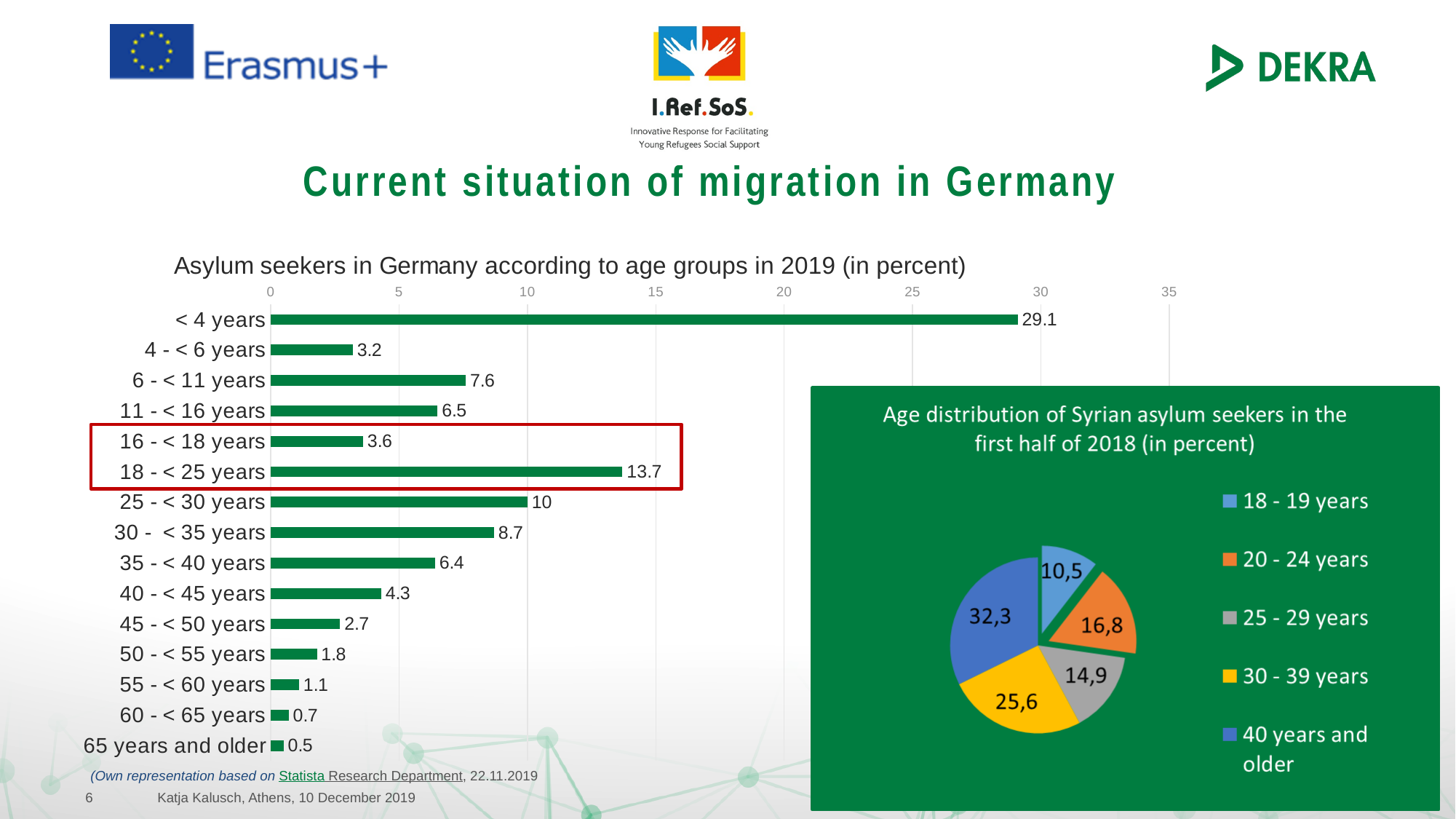
In the pie chart 'Age distribution of Syrian asylum seekers in the first half of 2018 (in percent)', which age group has the smallest slice? 18 - 19 years In the bar chart 'Asylum seekers in Germany according to age groups in 2019 (in percent)', what is the value for '18 - < 25 years'? 13.7 In the pie chart 'Age distribution of Syrian asylum seekers in the first half of 2018 (in percent)', what colour is the slice for '30 - 39 years'? Yellow How many entries does the legend of the pie chart 'Age distribution of Syrian asylum seekers in the first half of 2018 (in percent)' list? 5 In the bar chart 'Asylum seekers in Germany according to age groups in 2019 (in percent)', what is the difference between the values for '18 - < 25 years' and '16 - < 18 years'? 10.1 In the bar chart 'Asylum seekers in Germany according to age groups in 2019 (in percent)', which age group has the highest value? < 4 years What kind of chart is 'Asylum seekers in Germany according to age groups in 2019 (in percent)'? Bar chart How many age groups are shown in the bar chart 'Asylum seekers in Germany according to age groups in 2019 (in percent)'? 15 In the pie chart 'Age distribution of Syrian asylum seekers in the first half of 2018 (in percent)', what is the value for '40 years and older'? 32,3 In the bar chart 'Asylum seekers in Germany according to age groups in 2019 (in percent)', what is the value for '< 4 years'? 29.1 In the bar chart 'Asylum seekers in Germany according to age groups in 2019 (in percent)', which is larger: the value for '6 - < 11 years' or '11 - < 16 years'? 6 - < 11 years In the bar chart 'Asylum seekers in Germany according to age groups in 2019 (in percent)', which age group has the lowest value? 65 years and older